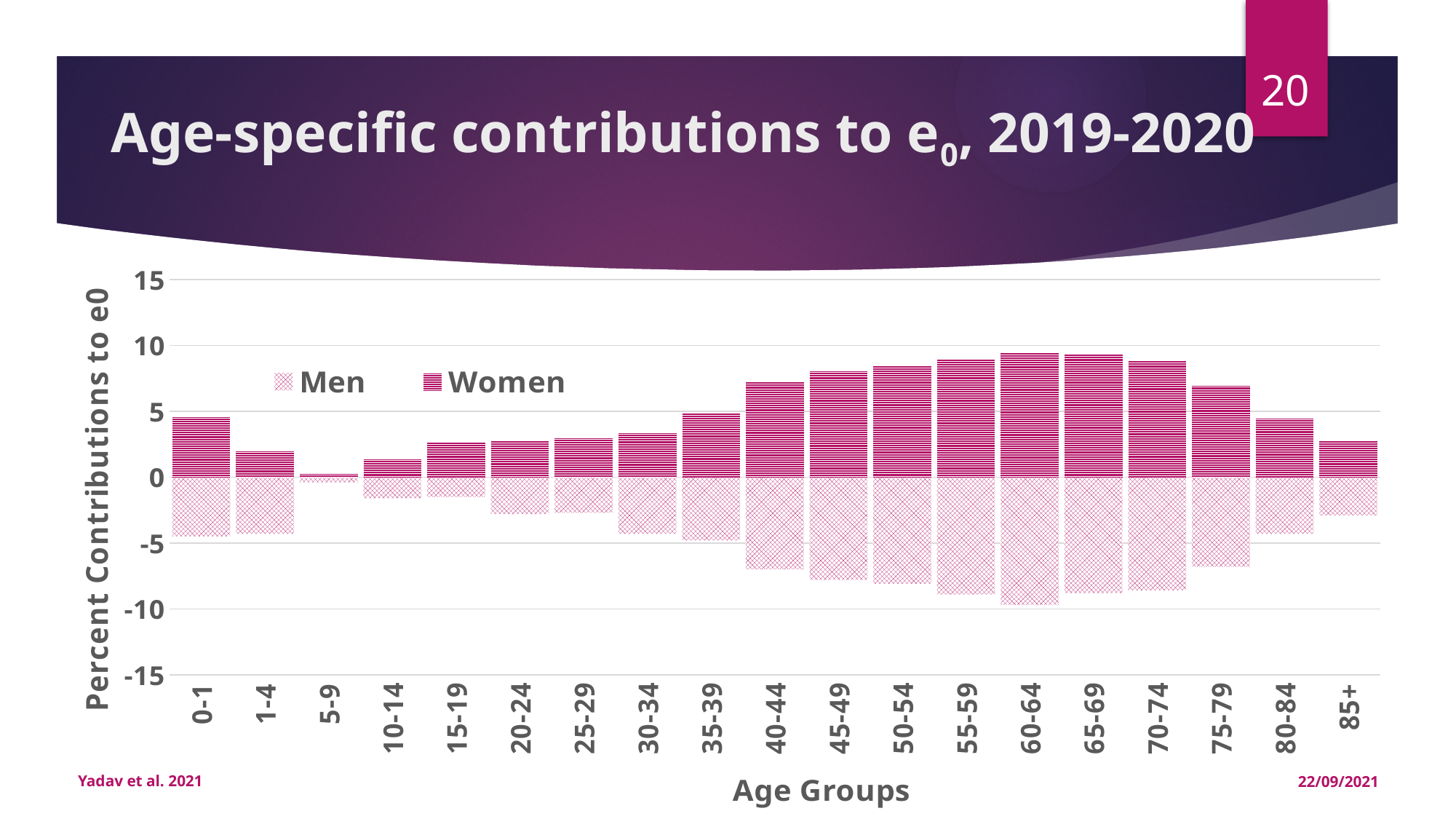
Which has the larger Women value, 30-34 or 35-39? 35-39 Is the Women value for 40-44 greater or less than 5? greater Which age group has the most negative Men value? 60-64 Do the Women values rise or fall from the 5-9 age group to the 60-64 age group? rise How many age groups are shown on the x axis? 19 Is the Men value for 60-64 greater or less than -5? less How many series does the legend list? 2 What kind of chart is shown on the slide? bar chart Is the Women value for 0-1 greater or less than 5? less Which age group has the smallest Women value? 5-9 What is the title of the x axis? Age Groups